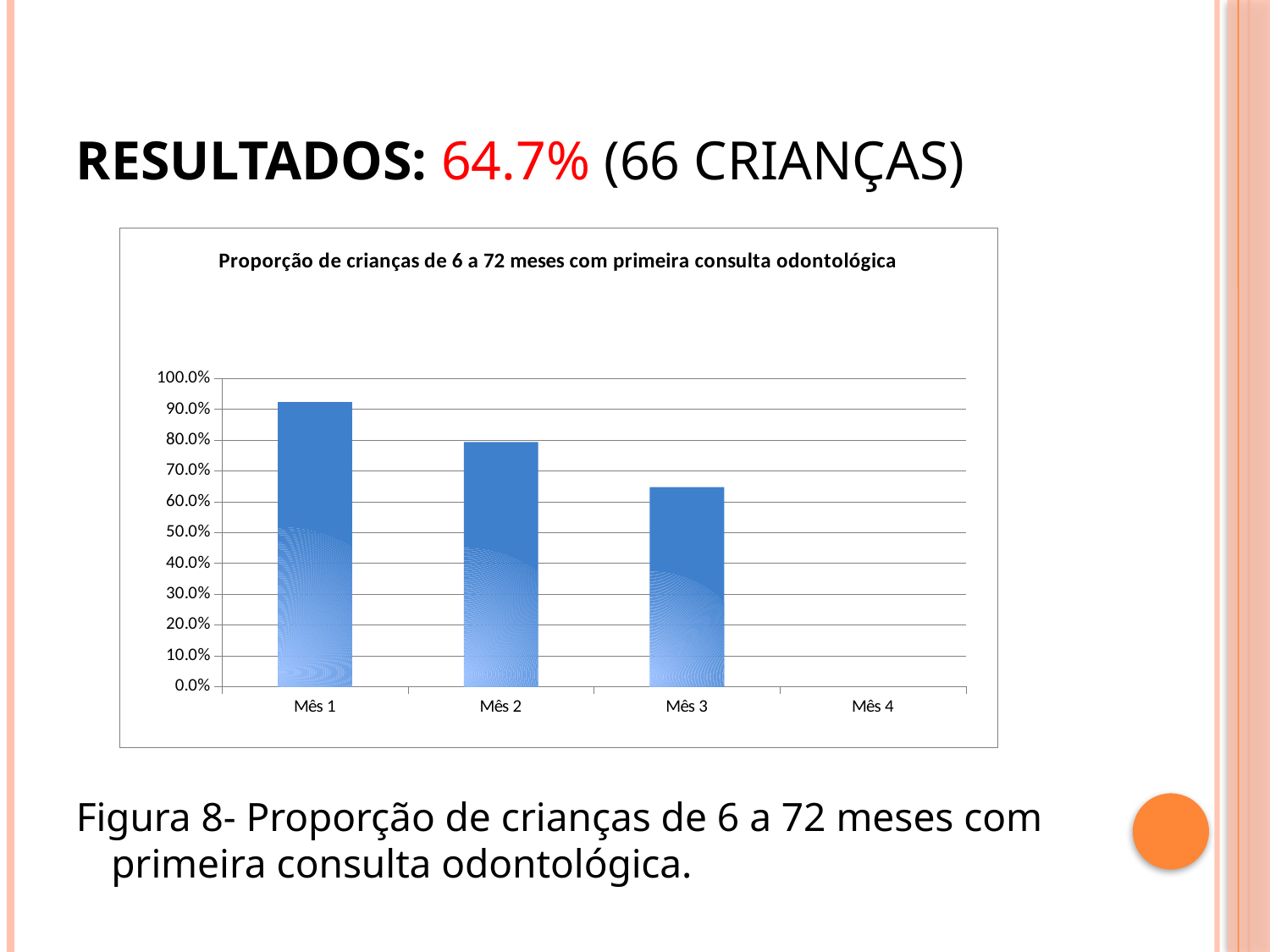
How many categories are shown on the x axis of the chart? 4 Which is larger, the value for Mês 2 or the value for Mês 3? Mês 2 Which month has the highest bar in the chart? Mês 1 Among the months that have a bar plotted, which has the lowest value? Mês 3 Is the value for Mês 1 greater or less than 80.0%? greater What is the title of the chart? Proporção de crianças de 6 a 72 meses com primeira consulta odontológica Is the value for Mês 2 greater or less than 70.0%? greater Which month on the x axis has no bar plotted? Mês 4 Which is larger, the value for Mês 1 or the value for Mês 2? Mês 1 Do the bar values rise or fall from Mês 1 to Mês 3? fall What kind of chart is shown on the slide? bar chart Is the value for Mês 3 greater or less than 70.0%? less